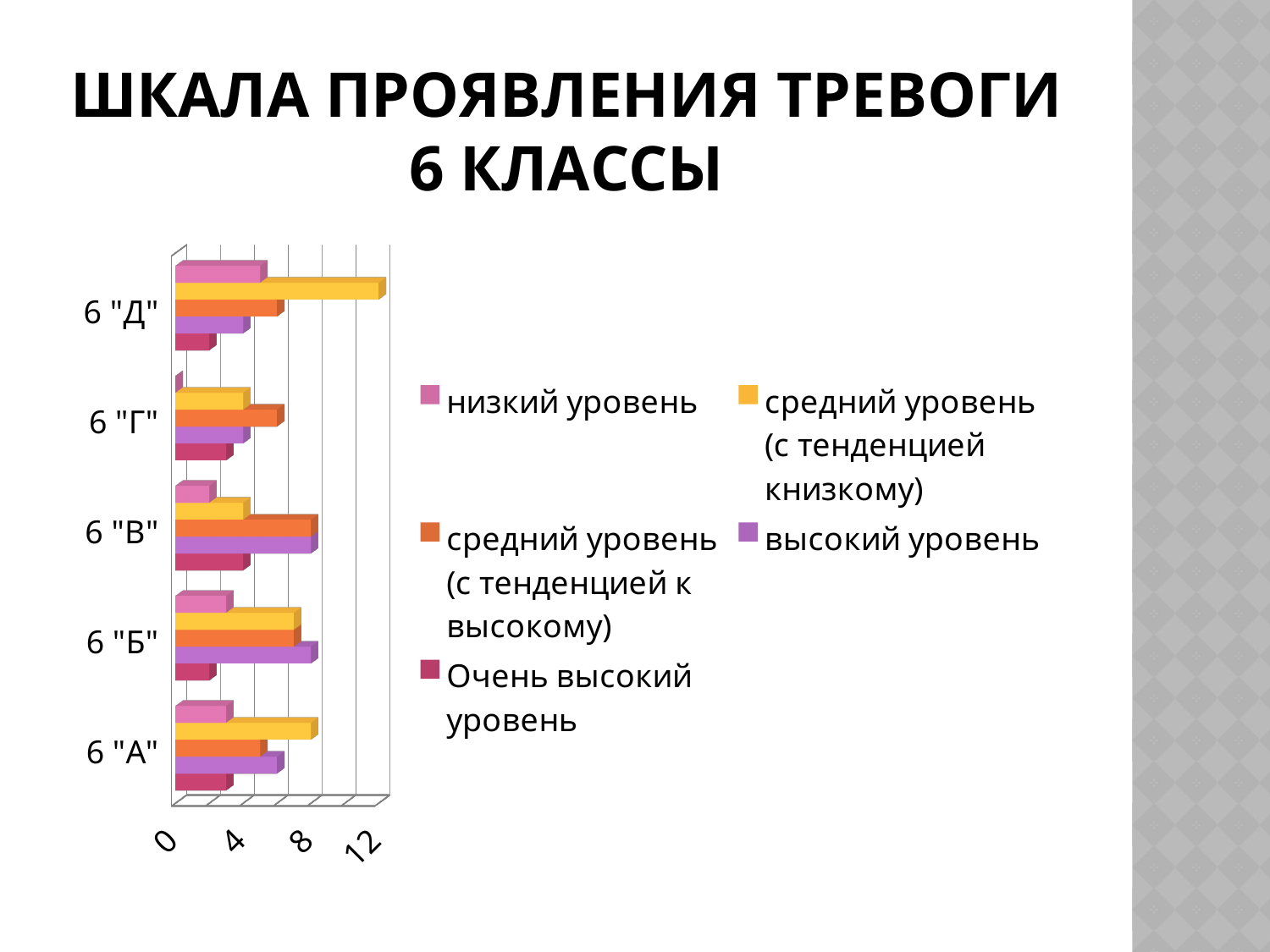
Which class has the highest value for "средний уровень (с тенденцией к низкому)"? 6 "Д" Is the value of "средний уровень (с тенденцией к низкому)" for 6 "А" greater or less than 4? greater What kind of chart is shown on the slide? bar chart What is the title of the slide? ШКАЛА ПРОЯВЛЕНИЯ ТРЕВОГИ 6 КЛАССЫ Is the value of "Очень высокий уровень" for 6 "Д" greater or less than 4? less How many classes (categories) are shown on the chart? 5 Is the value of "низкий уровень" for 6 "Г" greater or less than 4? less For 6 "В", which is larger: "низкий уровень" or "средний уровень (с тенденцией к высокому)"? средний уровень (с тенденцией к высокому) How many series does the legend list? 5 For 6 "Д", which is larger: "средний уровень (с тенденцией к низкому)" or "средний уровень (с тенденцией к высокому)"? средний уровень (с тенденцией к низкому)